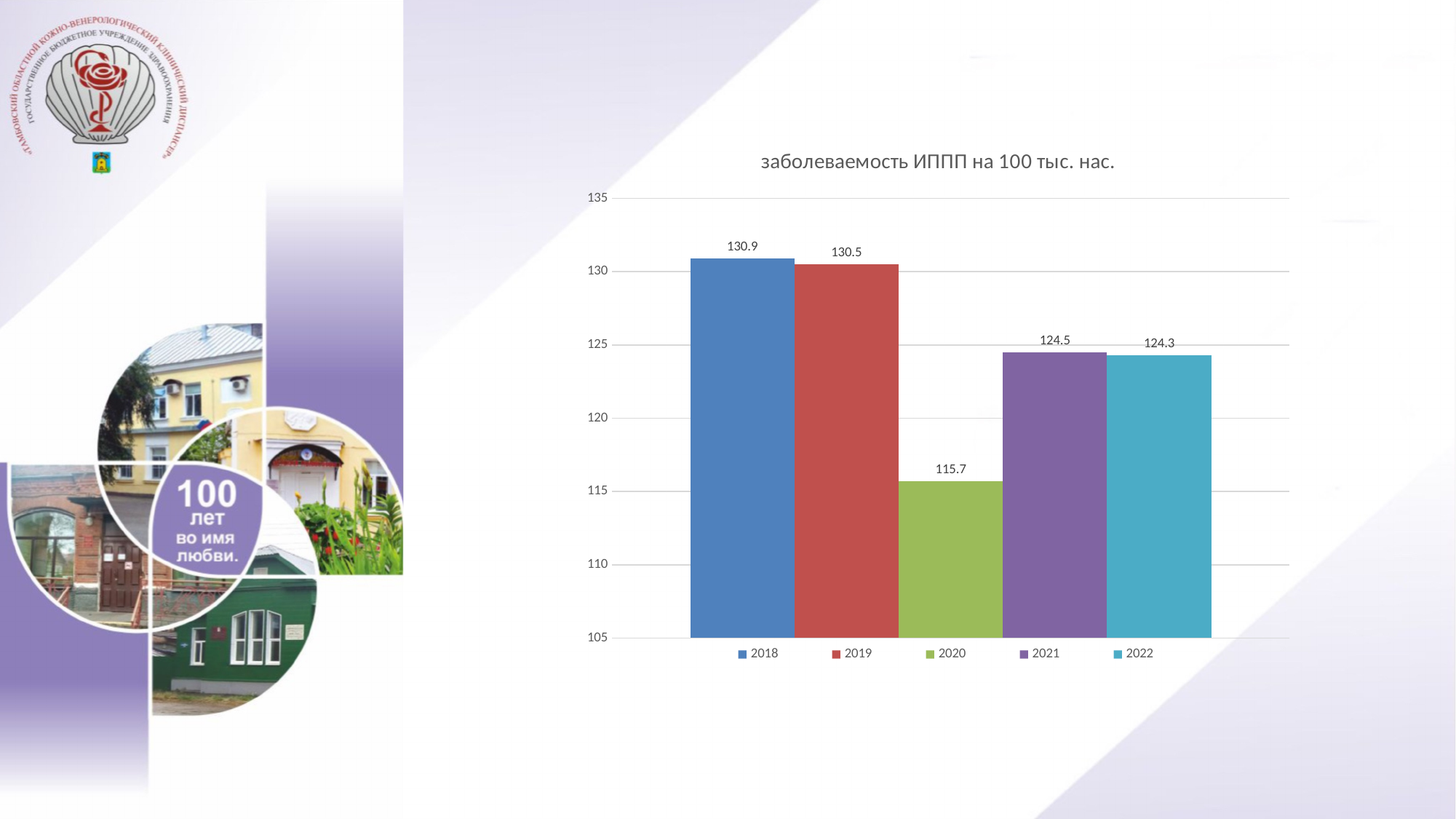
Which year has the lowest value? 2020 What kind of chart is shown on the slide? bar chart What is the title of the chart? заболеваемость ИППП на 100 тыс. нас. How many years are shown in the chart? 5 What is the value for 2018? 130.9 Which year has the highest value? 2018 What is the value for 2020? 115.7 Which is larger, the value for 2021 or the value for 2020? 2021 What is the value for 2022? 124.3 What is the difference between the values for 2019 and 2020? 14.8 What is the difference between the values for 2018 and 2022? 6.6 Is the value for 2021 greater or less than 120? greater